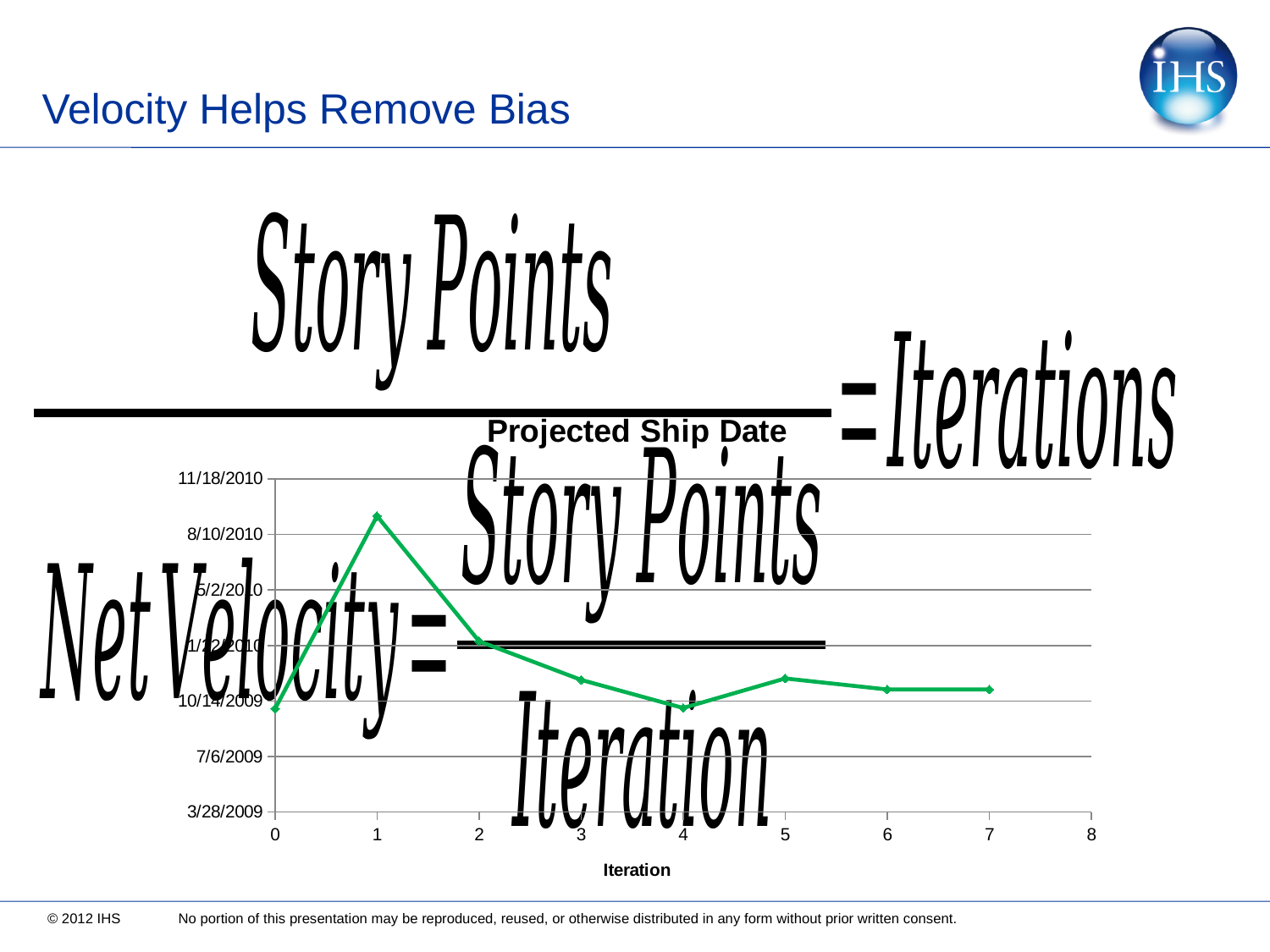
Is the projected ship date at iteration 7 greater or less than 7/6/2009? greater Is the projected ship date at iteration 4 greater or less than 1/22/2010? less Which has the later projected ship date, iteration 1 or iteration 4? iteration 1 How many data points are plotted on the line? 8 Is the projected ship date at iteration 3 greater or less than 1/22/2010? less Does the projected ship date rise or fall from iteration 1 to iteration 2? fall What is the label of the x axis of the chart? Iteration Which has the later projected ship date, iteration 2 or iteration 3? iteration 2 What kind of chart is shown on the slide? line chart What is the title of the chart? Projected Ship Date At which iteration is the projected ship date the latest (highest point)? 1